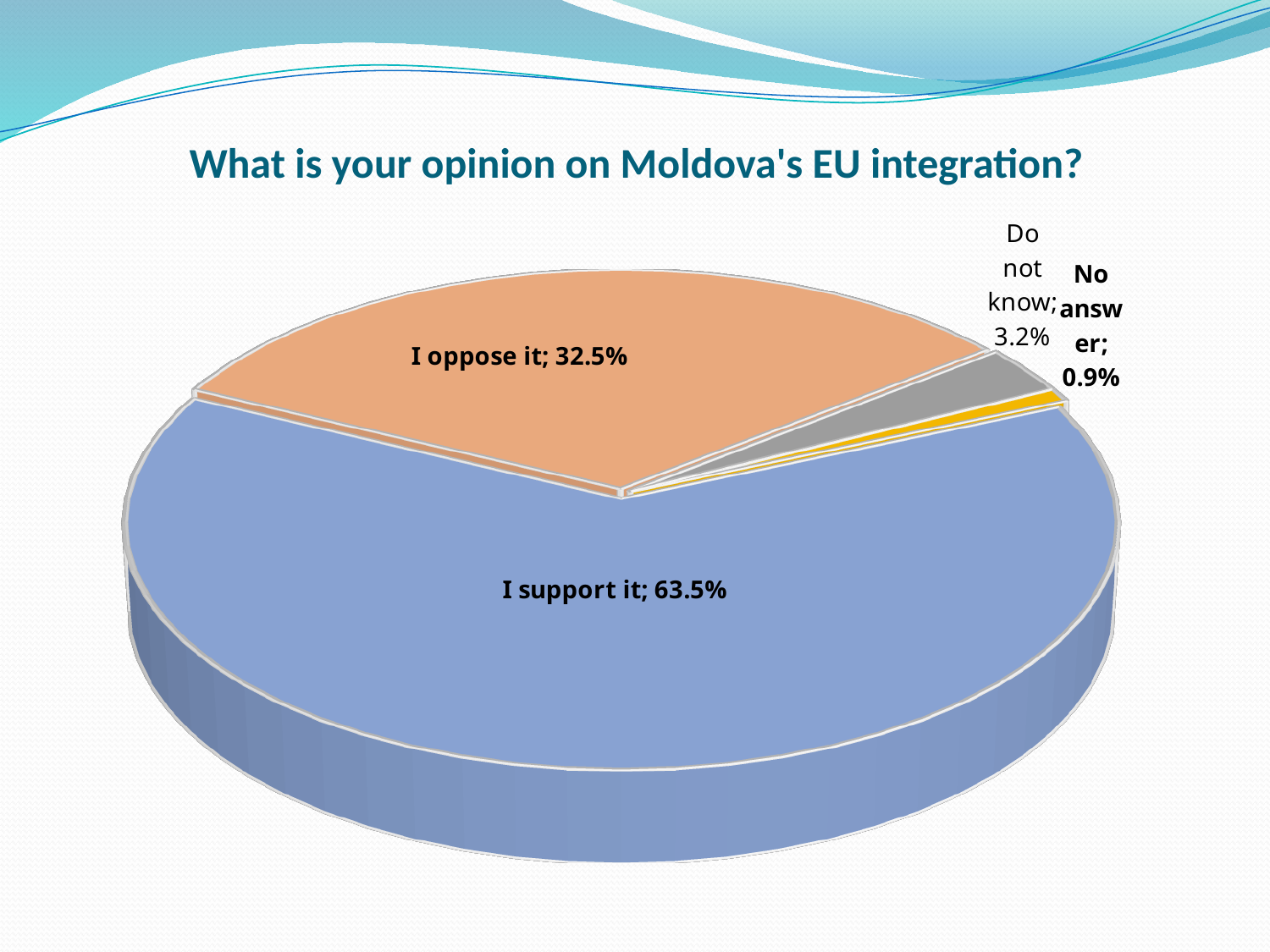
What colour is the "I oppose it" slice? Orange Which response has the smallest share of the pie? No answer What percentage of respondents gave "No answer"? 0.9% What percentage of respondents said "I oppose it"? 32.5% Which response has the largest share of the pie? I support it What percentage of respondents answered "Do not know"? 3.2% What kind of chart is shown on the slide? Pie chart What is the difference in percentage points between "I support it" and "I oppose it"? 31 percentage points Which is larger, the share for "Do not know" or the share for "No answer"? Do not know What is the title of the chart? What is your opinion on Moldova's EU integration? What percentage of respondents said "I support it"? 63.5% How many slices does the pie chart have? 4